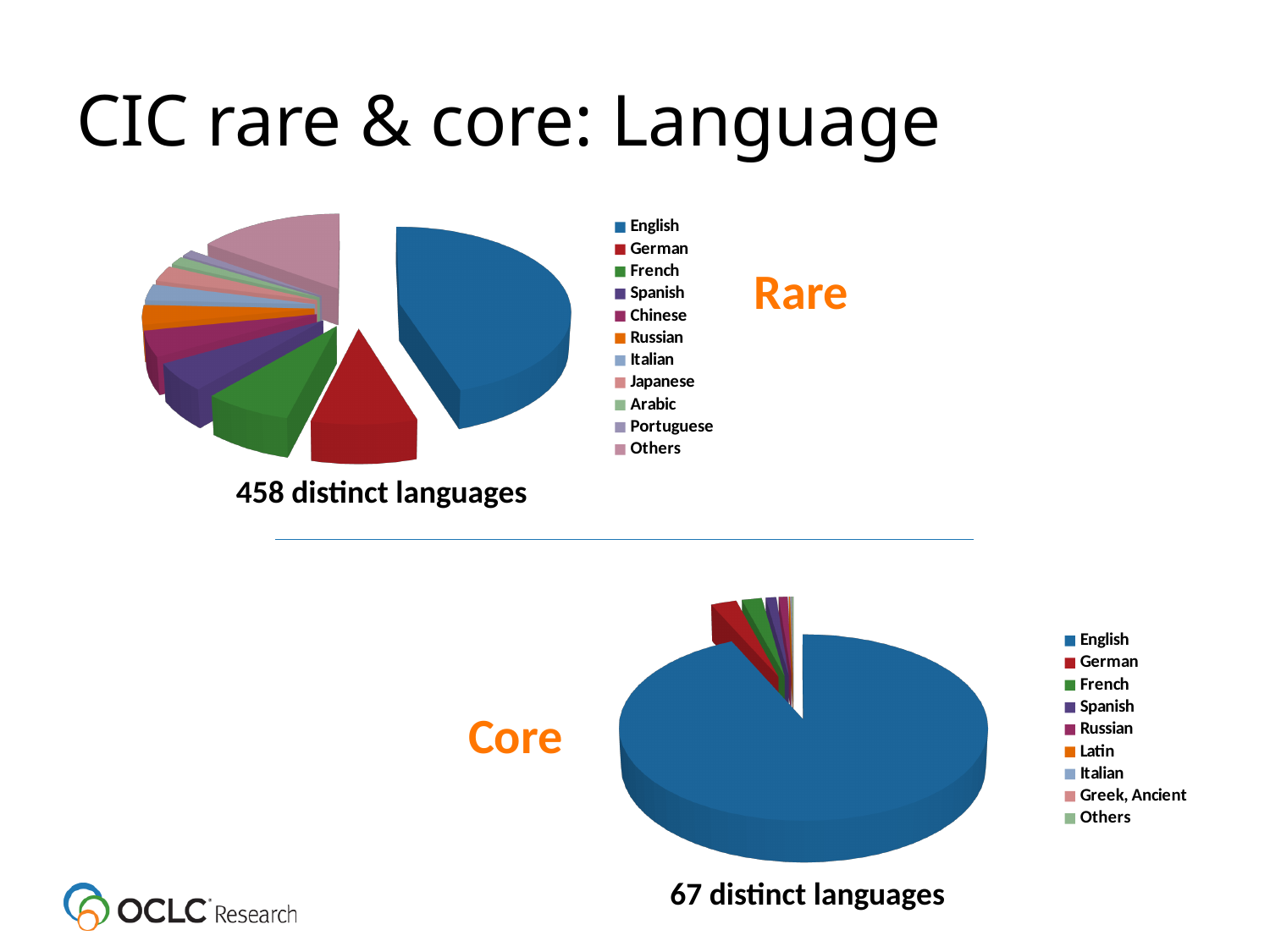
In the Rare chart, which slice is larger, French or Arabic? French In the Rare chart, which language has the largest slice? English In the Core chart, which language has the largest slice? English How many distinct languages does the caption under the Core chart report? 67 distinct languages In the Rare chart, which slice is larger, German or Portuguese? German In the Rare chart, which slice is larger, English or German? English How many categories does the legend of the Rare chart list? 11 How many categories does the legend of the Core chart list? 9 How many distinct languages does the caption under the Rare chart report? 458 distinct languages What kind of chart is the Core chart? Pie chart What kind of chart is the Rare chart? Pie chart